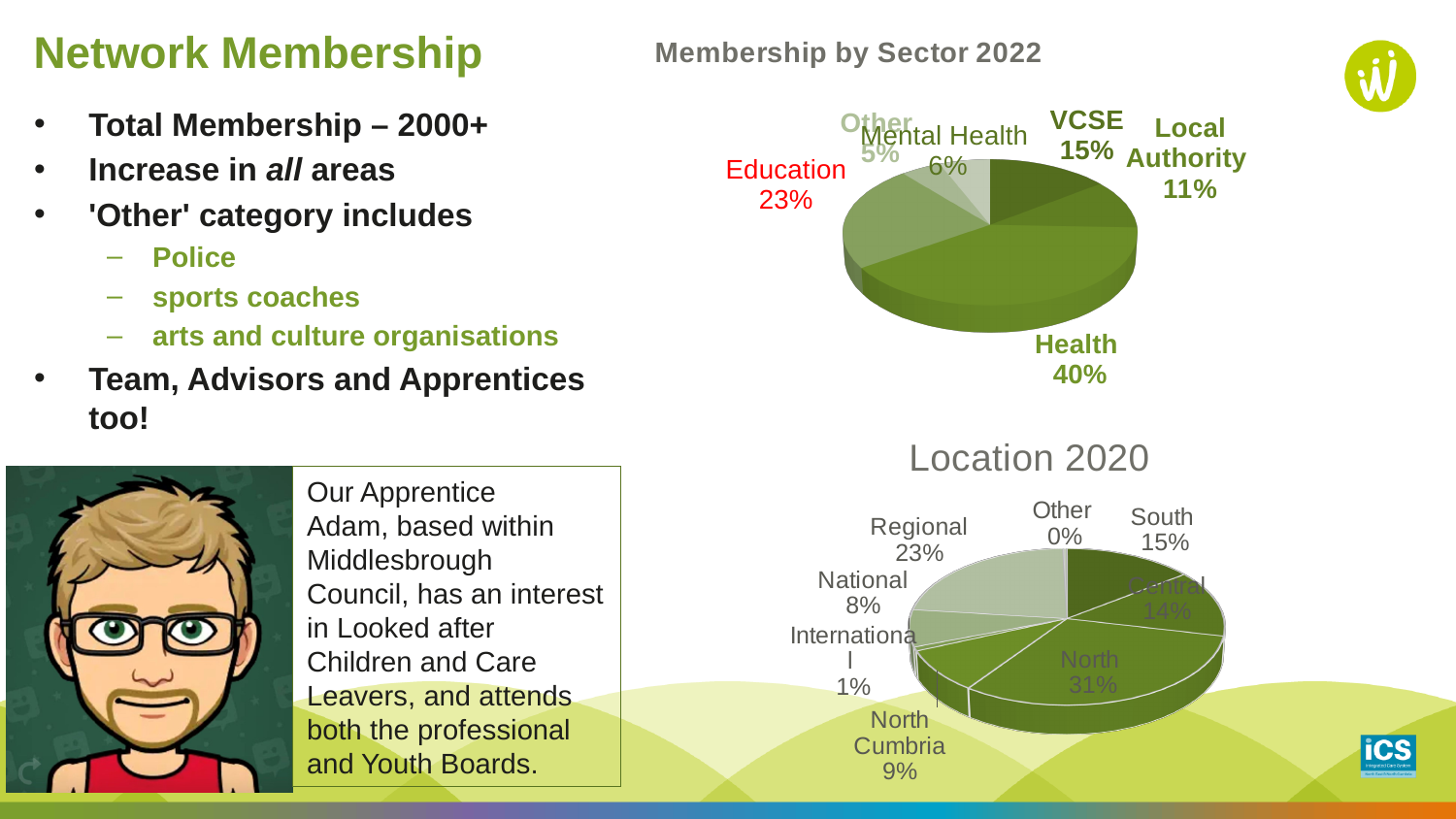
In the 'Location 2020' chart, which is larger, Regional or South? Regional In the 'Membership by Sector 2022' chart, what is the difference between the VCSE share and the Local Authority share? 4% In the 'Location 2020' chart, what share does North Cumbria have? 9% In the 'Location 2020' chart, what share does North have? 31% In the 'Location 2020' chart, how many locations are shown? 8 What kind of chart is 'Membership by Sector 2022'? Pie chart In the 'Membership by Sector 2022' chart, how many sectors are shown? 6 In the 'Membership by Sector 2022' chart, which sector has the largest share? Health In the 'Membership by Sector 2022' chart, which sector has the smallest share? Other In the 'Membership by Sector 2022' chart, what share does Health have? 40% In the 'Membership by Sector 2022' chart, what share does Education have? 23% In the 'Location 2020' chart, which location has the largest share? North